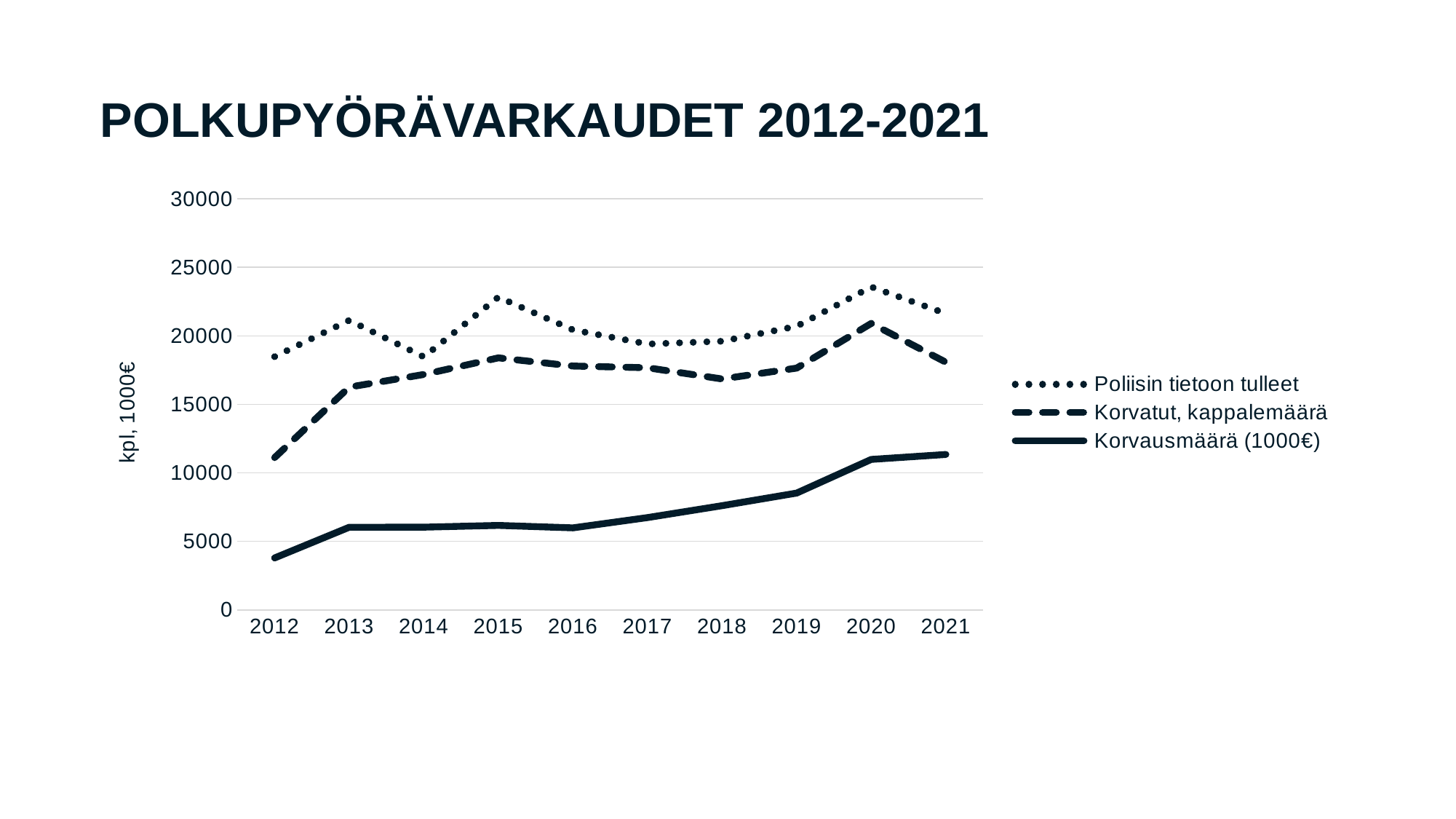
In which year is the value for Poliisin tietoon tulleet highest? 2020 Does the value for Korvausmäärä (1000€) rise or fall from 2016 to 2021? rise How many years are plotted along the x axis? 10 In 2013, which is larger: Poliisin tietoon tulleet or Korvatut, kappalemäärä? Poliisin tietoon tulleet Is the value for Korvatut, kappalemäärä in 2012 greater or less than 15000? less In which year is the value for Korvatut, kappalemäärä highest? 2020 What kind of chart is shown on the slide? Line chart In which year is the value for Korvausmäärä (1000€) lowest? 2012 In which year is the value for Korvatut, kappalemäärä lowest? 2012 Is the value for Poliisin tietoon tulleet in 2015 greater or less than 20000? greater Is the value for Korvausmäärä (1000€) in 2020 greater or less than 10000? greater How many series does the legend list? 3